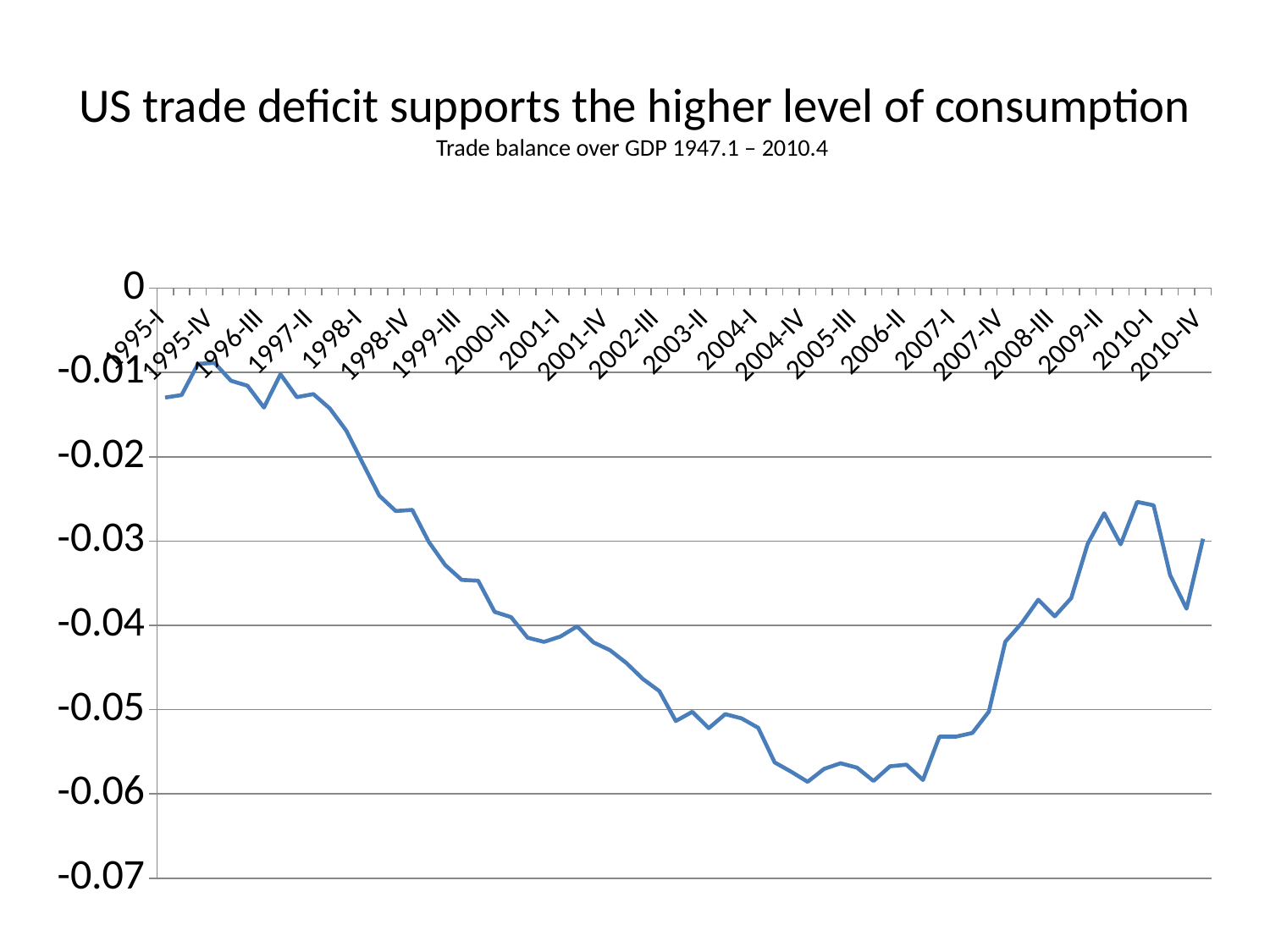
What kind of chart is shown on the slide? line chart What period does the chart subtitle say the trade balance over GDP covers? 1947.1 – 2010.4 How many quarter labels are shown on the x axis? 22 Does the trade balance over GDP rise or fall from 2006-II to 2009-II? rise Is the value for 2009-II greater or less than -0.03? greater What is the title of the slide? US trade deficit supports the higher level of consumption Is the value for 2004-IV greater or less than -0.05? less Is the value for 1995-I greater or less than -0.02? greater Which has the higher trade balance over GDP, 1997-II or 2002-III? 1997-II Does the trade balance over GDP rise or fall from 1995-I to 2004-IV? fall Which has the lower trade balance over GDP, 1995-I or 2005-III? 2005-III